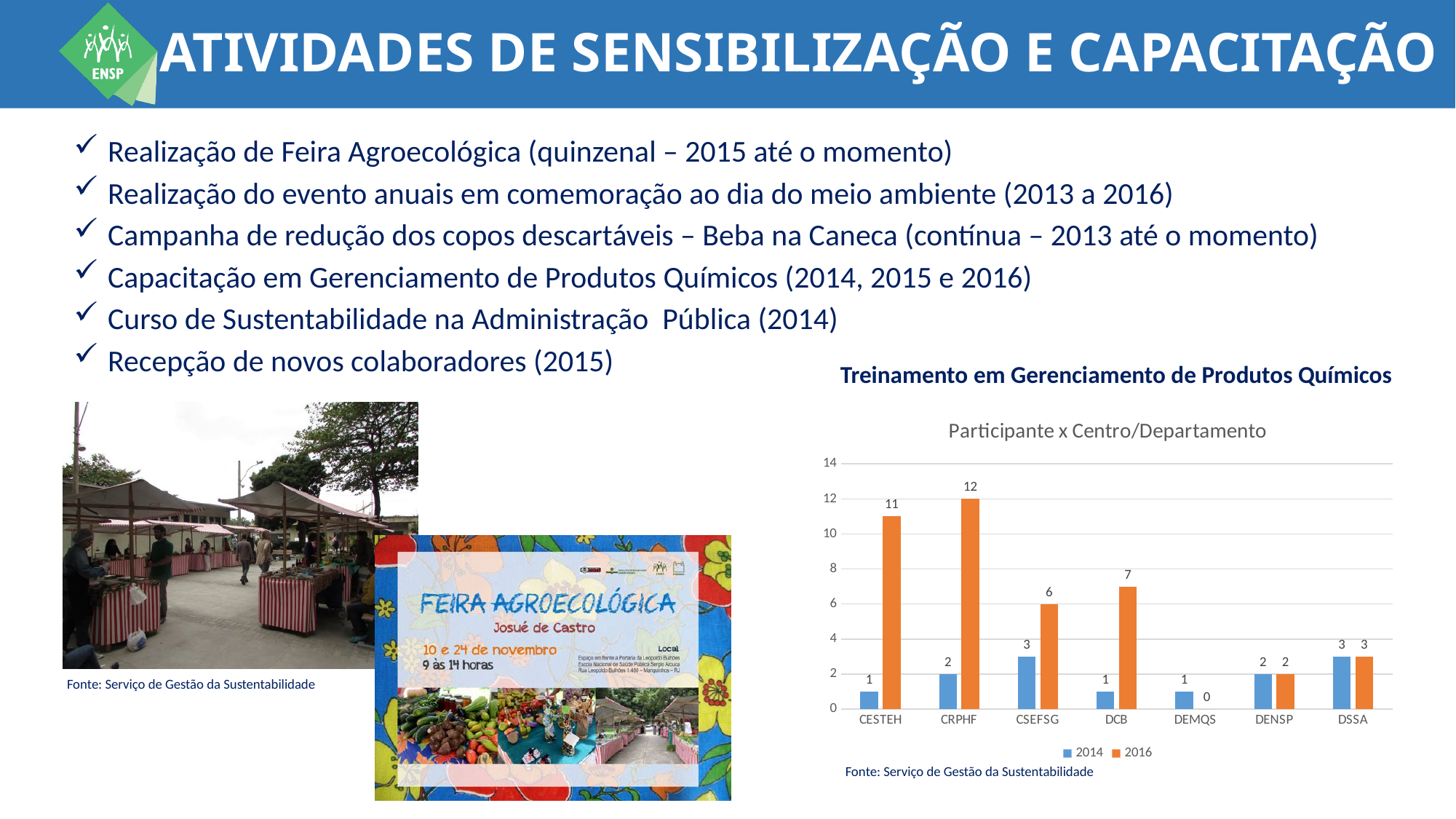
What is the 2014 value for CSEFSG? 3 What is the 2016 value for CRPHF? 12 How many series does the legend list? 2 Which is larger for DCB, the 2014 value or the 2016 value? 2016 What is the 2016 value for DEMQS? 0 How many categories are shown on the x axis? 7 Which category has the highest 2016 value? CRPHF Which category has the lowest 2016 value? DEMQS What is the chart's title? Participante x Centro/Departamento What kind of chart is shown? bar chart Which series is shown in orange? 2016 What is the difference between the 2016 and 2014 values for CESTEH? 10